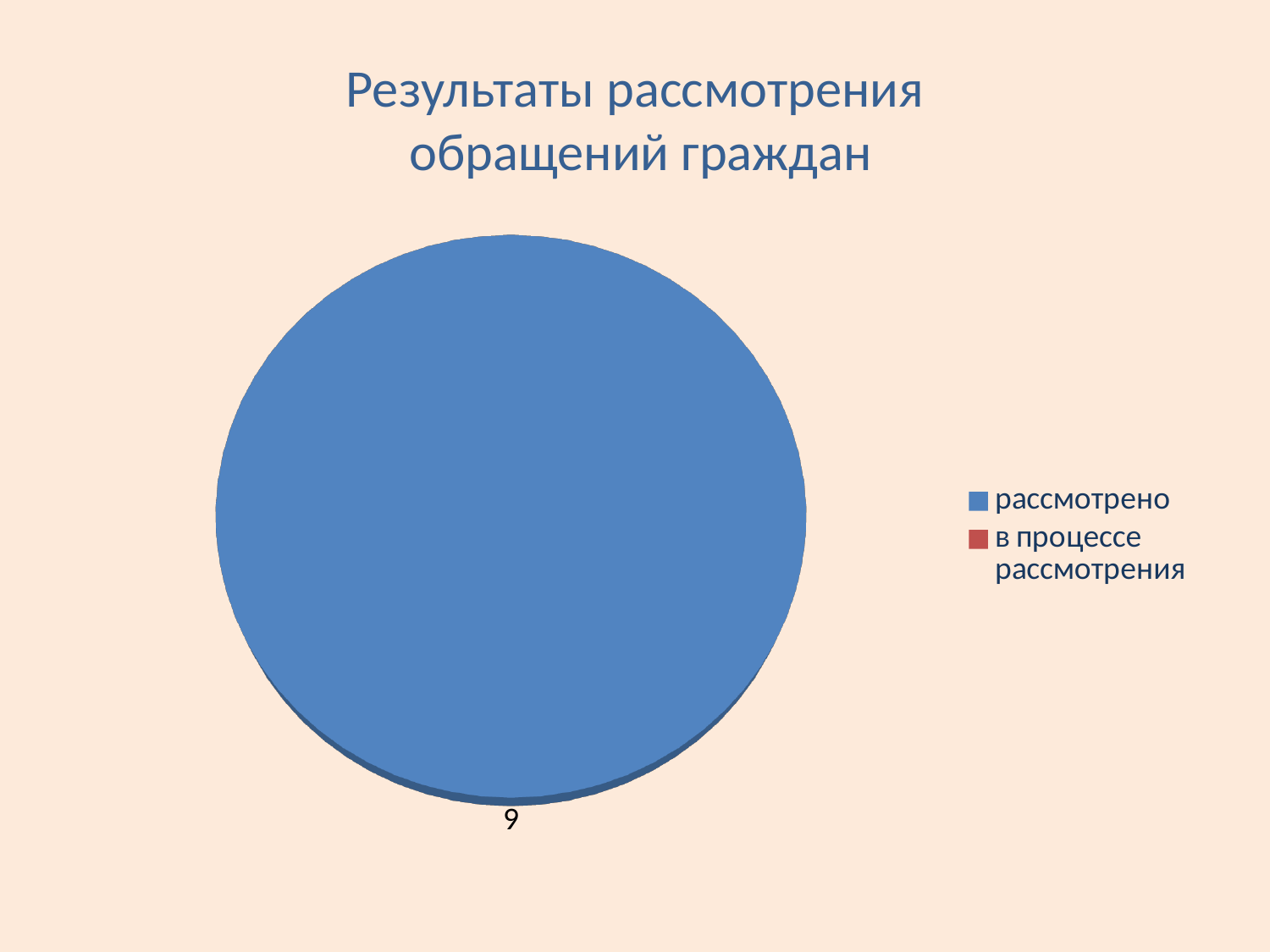
Which of the two categories, рассмотрено or в процессе рассмотрения, has the larger share of the pie? рассмотрено Which category makes up the largest share of the pie? рассмотрено Which category is shown in blue in the legend? рассмотрено What kind of chart is shown on the slide? pie chart What is the title of the chart? Результаты рассмотрения обращений граждан How many entries does the chart legend list? 2 What value is printed as the data label on the pie chart? 9 Which category has the smallest share of the pie? в процессе рассмотрения